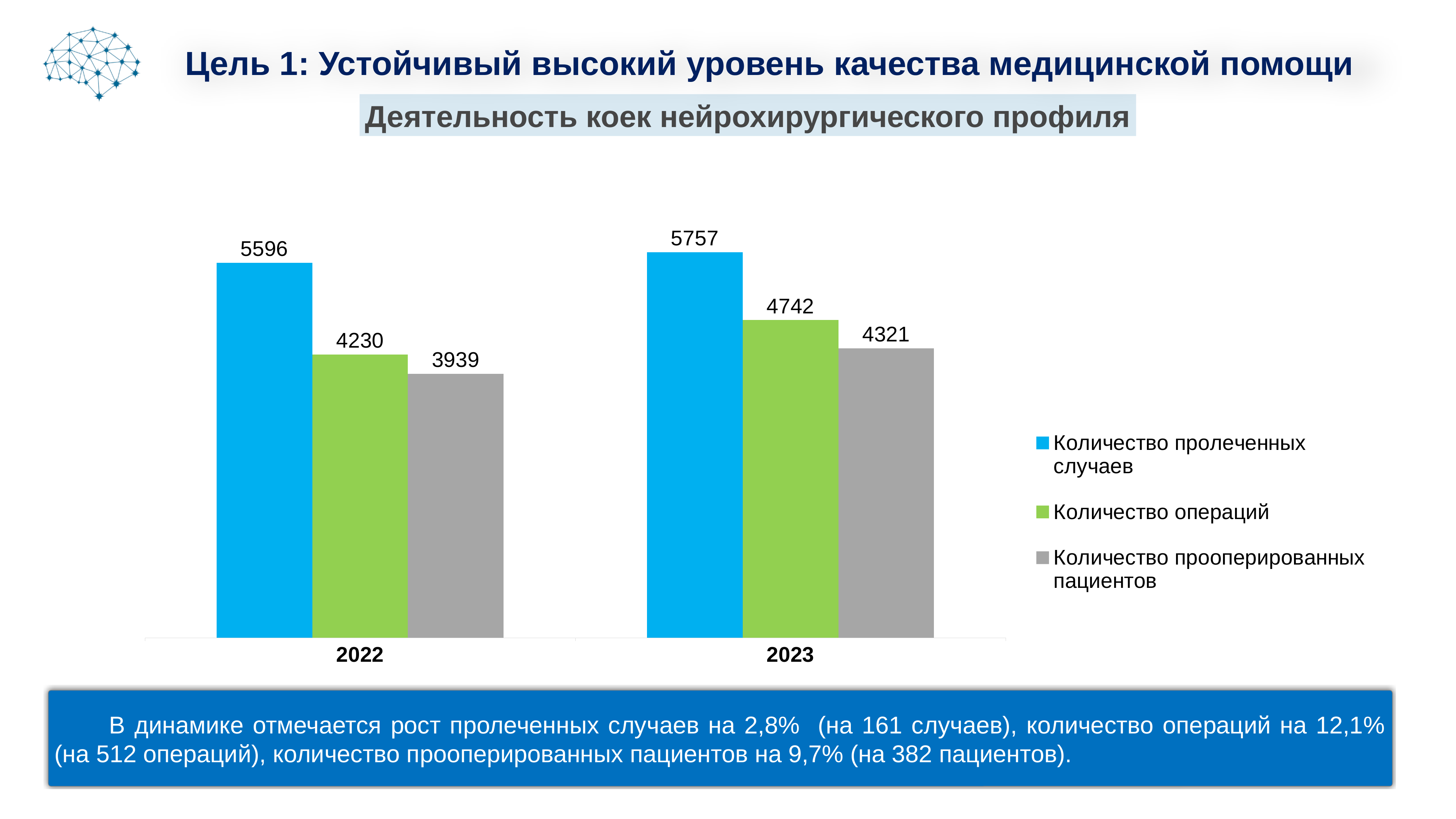
Which series has the lowest value in 2022? Количество прооперированных пациентов What is the value of Количество пролеченных случаев for 2023? 5757 Which is larger: Количество прооперированных пациентов in 2022 or in 2023? 2023 What is the value of Количество операций for 2023? 4742 Which series has the highest value in 2023? Количество пролеченных случаев What is the value of Количество пролеченных случаев for 2022? 5596 What kind of chart is shown on the slide? Bar chart What is the value of Количество прооперированных пациентов for 2022? 3939 How many series does the legend list? 3 What is the difference between Количество операций in 2023 and in 2022? 512 How many year categories are shown on the x axis? 2 What is the difference between Количество пролеченных случаев in 2023 and in 2022? 161